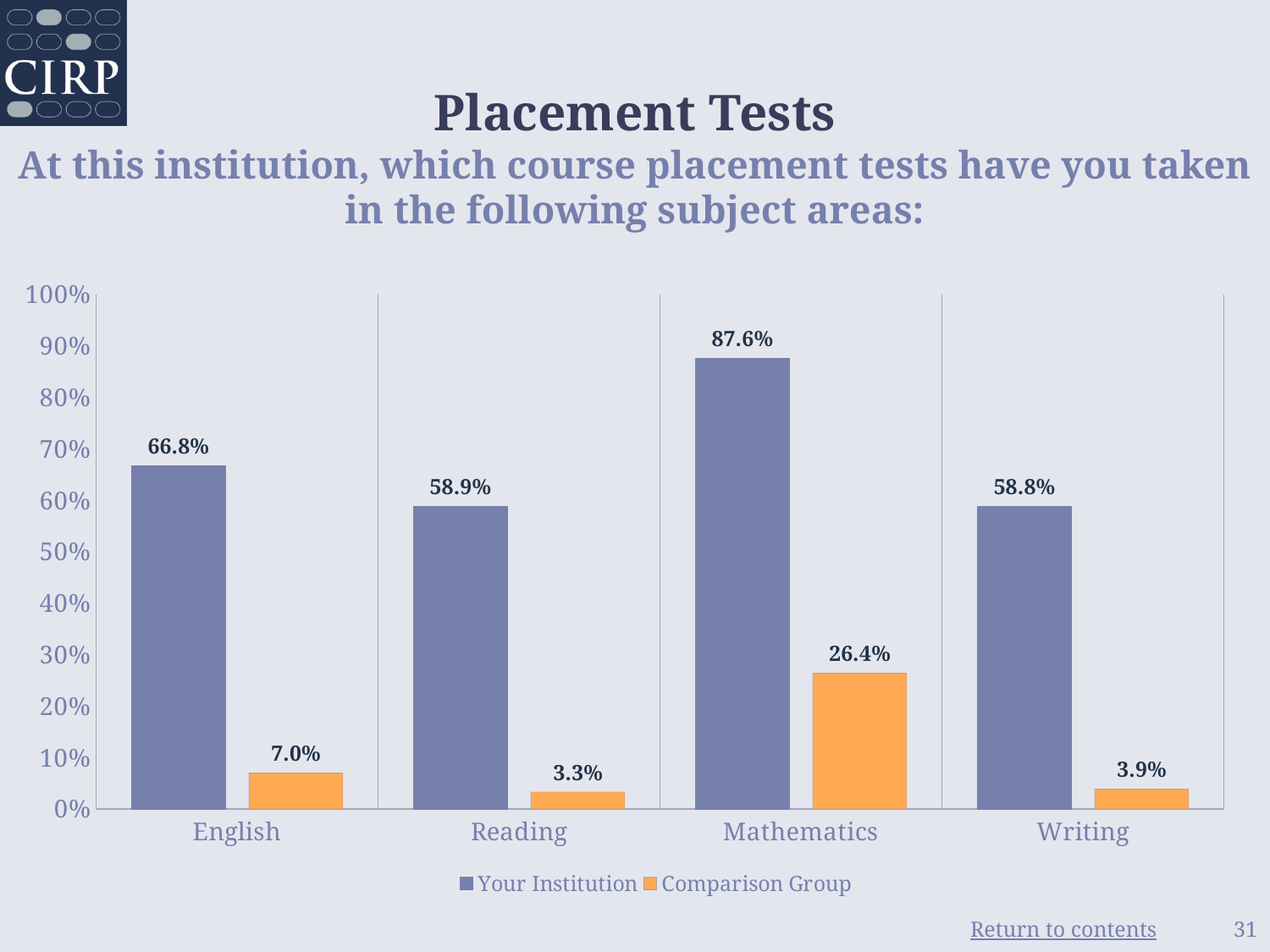
Is the value for Your Institution in Reading greater or less than 50%? greater Which subject area has the highest value for Your Institution? Mathematics Which is larger: the Comparison Group value for Mathematics or for Writing? Mathematics What is the value for the Comparison Group in English? 7.0% What is the value for Your Institution in Mathematics? 87.6% What kind of chart is shown on the slide? bar chart What is the difference between Your Institution's values for English and Reading? 7.9% What is the value for Your Institution in Writing? 58.8% How many series does the legend list? 2 What is the difference between Your Institution and the Comparison Group in Mathematics? 61.2% Which subject area has the lowest value for the Comparison Group? Reading How many subject areas are shown on the x axis? 4